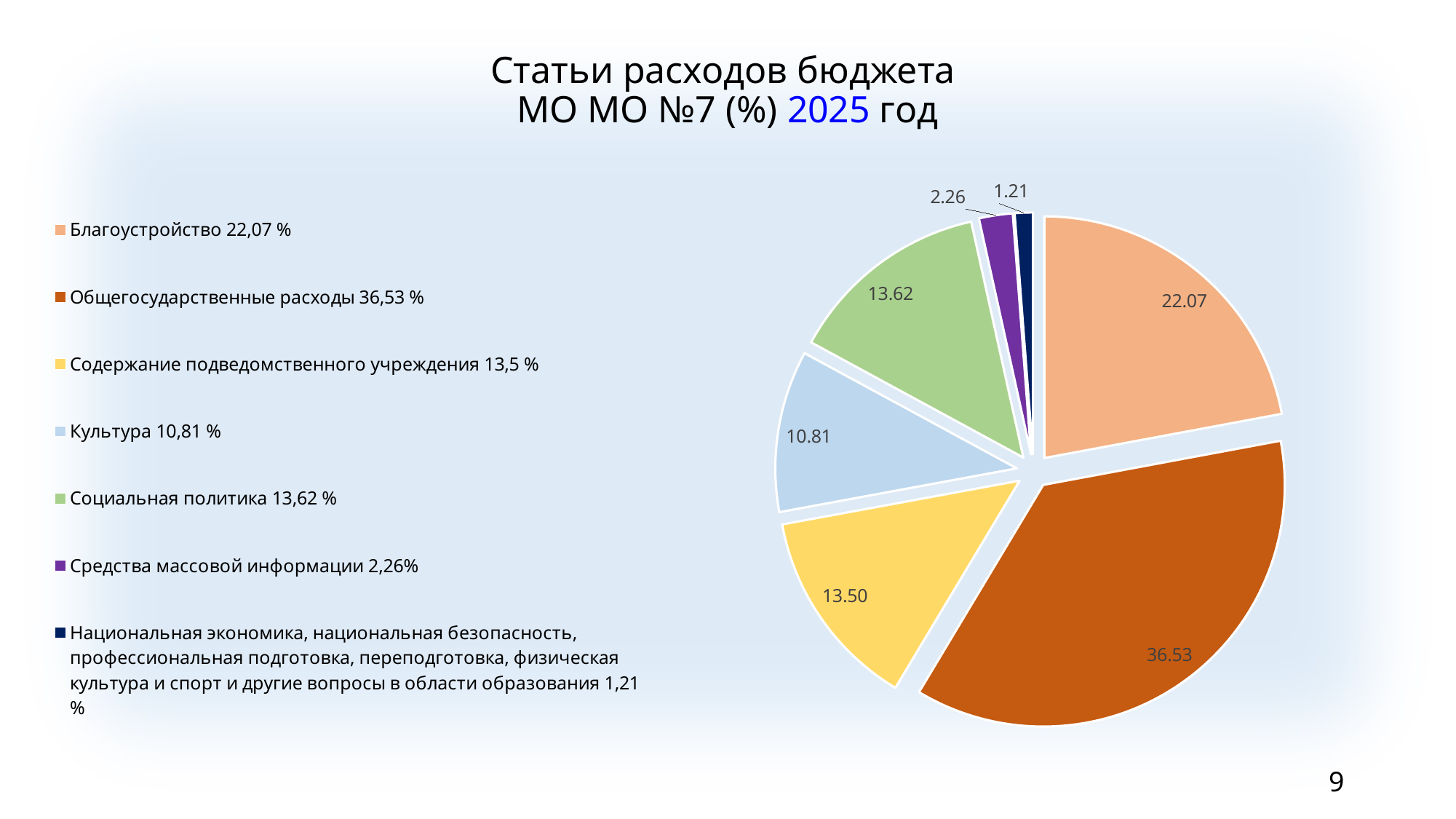
What is the value shown for Культура? 10.81 What is the value shown for Благоустройство? 22.07 Which category has the smallest slice of the pie? Национальная экономика, национальная безопасность, профессиональная подготовка, переподготовка, физическая культура и спорт и другие вопросы в области образования How many slices does the pie chart have? 7 What kind of chart is shown on the slide? pie chart Which category has the largest slice of the pie? Общегосударственные расходы Which is larger, the slice for Культура or the slice for Содержание подведомственного учреждения? Содержание подведомственного учреждения What is the difference between the values for Общегосударственные расходы and Благоустройство? 14.46 What colour is the slice for Социальная политика? green What is the value shown for Средства массовой информации? 2.26 What is the difference between the values for Социальная политика and Содержание подведомственного учреждения? 0.12 What is the value shown for Общегосударственные расходы? 36.53